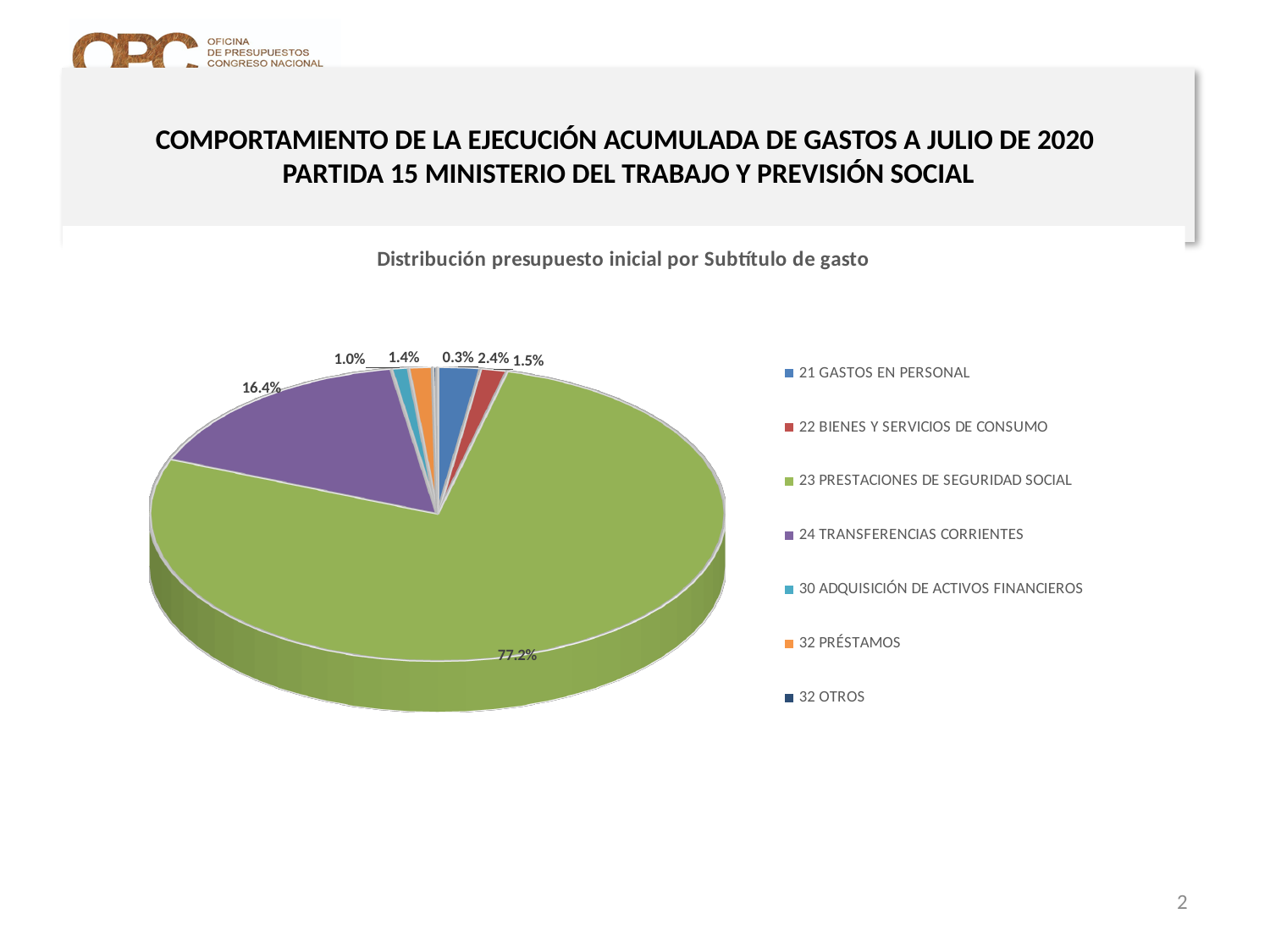
What kind of chart is shown on the slide? Pie chart What is the percentage shown for 21 GASTOS EN PERSONAL? 2.4% Which has the larger share, 21 GASTOS EN PERSONAL or 22 BIENES Y SERVICIOS DE CONSUMO? 21 GASTOS EN PERSONAL What is the smallest percentage labelled on the pie chart? 0.3% How many categories does the legend of the pie chart list? 7 Which category has the smallest share of the pie? 32 OTROS What share of the pie does 23 PRESTACIONES DE SEGURIDAD SOCIAL represent? 77.2% Which category has the largest share of the pie? 23 PRESTACIONES DE SEGURIDAD SOCIAL What is the title of the chart? Distribución presupuesto inicial por Subtítulo de gasto What is the difference in percentage points between 23 PRESTACIONES DE SEGURIDAD SOCIAL and 24 TRANSFERENCIAS CORRIENTES? 60.8 percentage points What is the percentage shown for 22 BIENES Y SERVICIOS DE CONSUMO? 1.5% What share of the pie does 24 TRANSFERENCIAS CORRIENTES represent? 16.4%